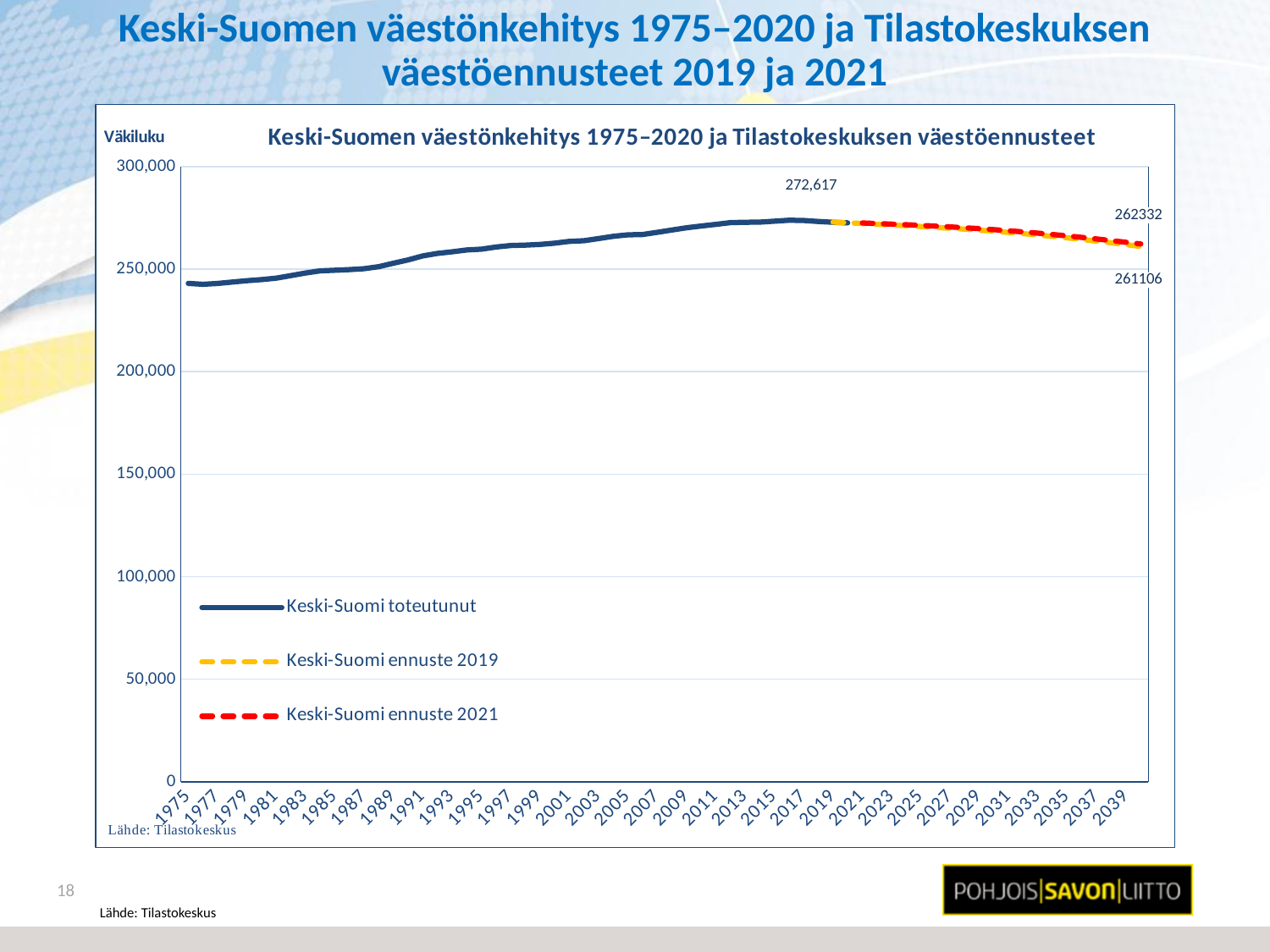
Do the forecast lines rise or fall from 2021 to 2039? fall What type of chart is shown on the slide? line chart Which year has the larger population value, 1975 or 2015? 2015 What is the highest data value labelled on the chart? 272,617 How many series does the chart legend list? 3 Is the population value for 2017 greater or less than 300,000? less Is the population value for 2001 greater or less than 250,000? greater What are the three series named in the chart legend? Keski-Suomi toteutunut, Keski-Suomi ennuste 2019, Keski-Suomi ennuste 2021 What is the label on the vertical axis of the chart? Väkiluku What is the difference between the two forecast end values labelled 262332 and 261106? 1226 Does the actual population (Keski-Suomi toteutunut) rise or fall between 1975 and 2015? rise Is the population value for 1975 greater or less than 250,000? less